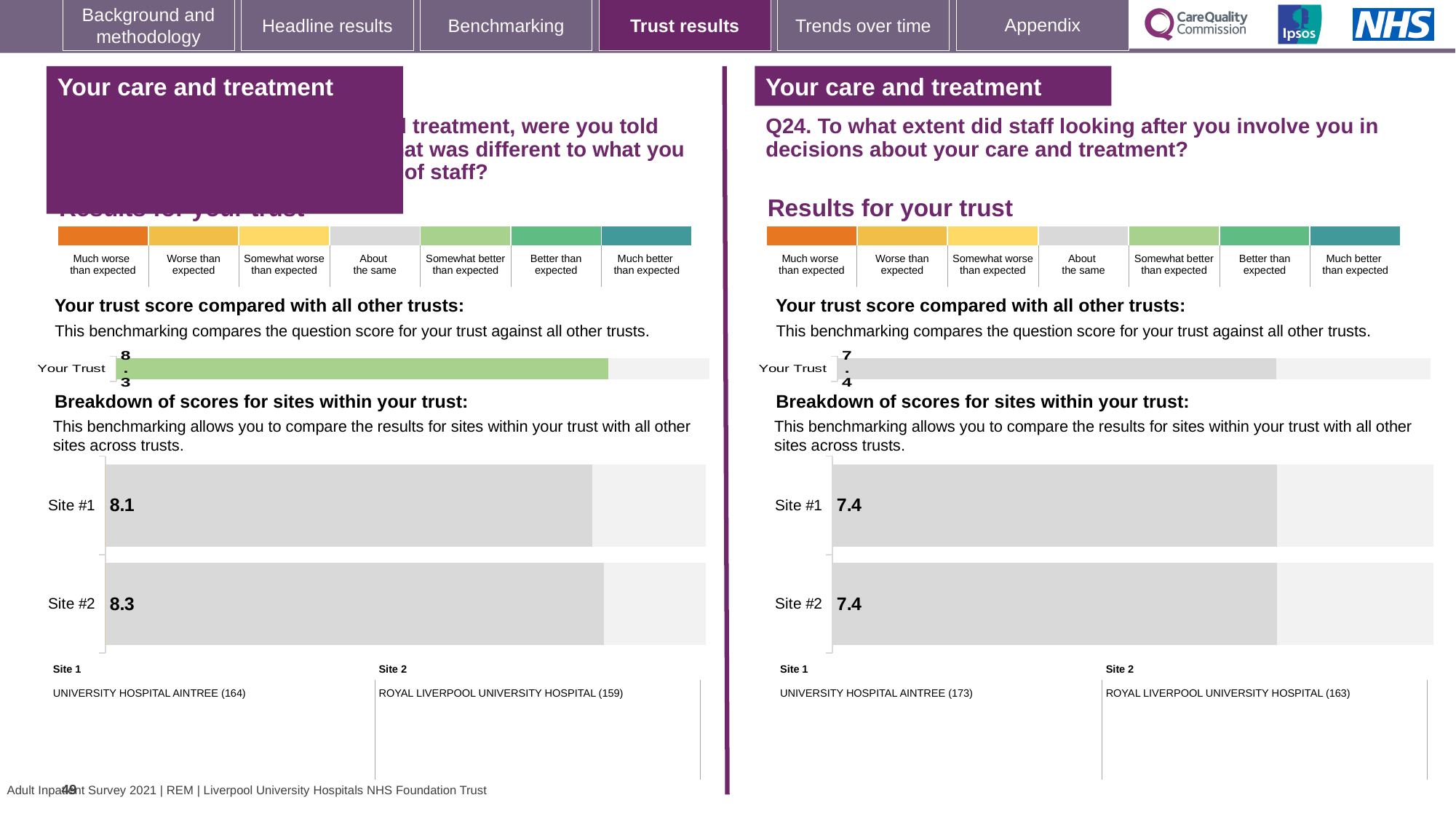
On the left-hand 'Breakdown of scores for sites within your trust' chart, what is the score for Site #1? 8.1 On the left-hand 'Your trust score compared with all other trusts' chart, what is the score for Your Trust? 8.3 On the right-hand (Q24) 'Breakdown of scores for sites within your trust' chart, what is the score for Site #1? 7.4 On the left-hand 'Breakdown of scores for sites within your trust' chart, how many sites are shown? 2 On the left-hand 'Breakdown of scores for sites within your trust' chart, what is the score for Site #2? 8.3 What kind of chart is used for the 'Breakdown of scores for sites within your trust' on the right-hand (Q24) side? Bar chart On the left-hand 'Breakdown of scores for sites within your trust' chart, what is the difference between the Site #2 and Site #1 scores? 0.2 On the right-hand (Q24) 'Breakdown of scores for sites within your trust' chart, is the Site #1 score larger than, smaller than, or equal to the Site #2 score? Equal On the right-hand (Q24) 'Your trust score compared with all other trusts' chart, what is the score for Your Trust? 7.4 On the left-hand side, which site is listed as Site 1 below the breakdown chart? UNIVERSITY HOSPITAL AINTREE (164) On the left-hand 'Breakdown of scores for sites within your trust' chart, which site has the higher score? Site #2 On the right-hand (Q24) 'Breakdown of scores for sites within your trust' chart, what is the score for Site #2? 7.4